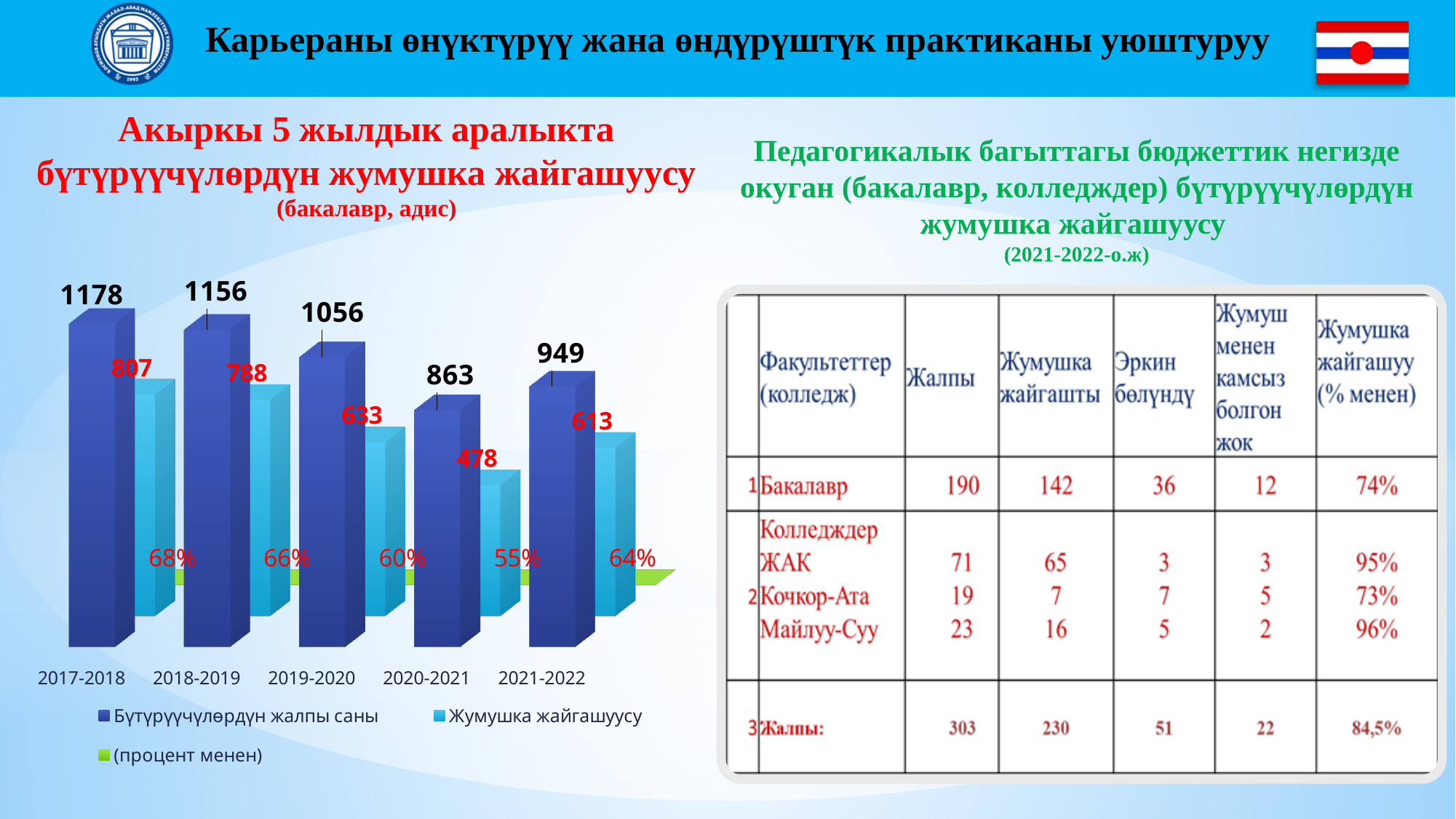
Which academic year has the lowest employment percentage? 2020-2021 What type of chart is shown on the left of the slide? bar chart What colour are the bars for the total number of graduates series? dark blue What is the employment value (Жумушка жайгашуусу) for 2020-2021? 478 Which academic year has the highest total number of graduates? 2017-2018 What is the total number of graduates (Бүтүрүүчүлөрдүн жалпы саны) for 2017-2018? 1178 What is the difference between the total number of graduates and the number employed in 2019-2020? 423 How many series does the chart legend list? 3 Which is larger: the number employed in 2018-2019 or in 2021-2022? 2018-2019 Does the total number of graduates rise or fall from 2017-2018 to 2020-2021? fall How many academic years are shown on the x axis of the chart? 5 What percentage is shown for 2021-2022? 64%